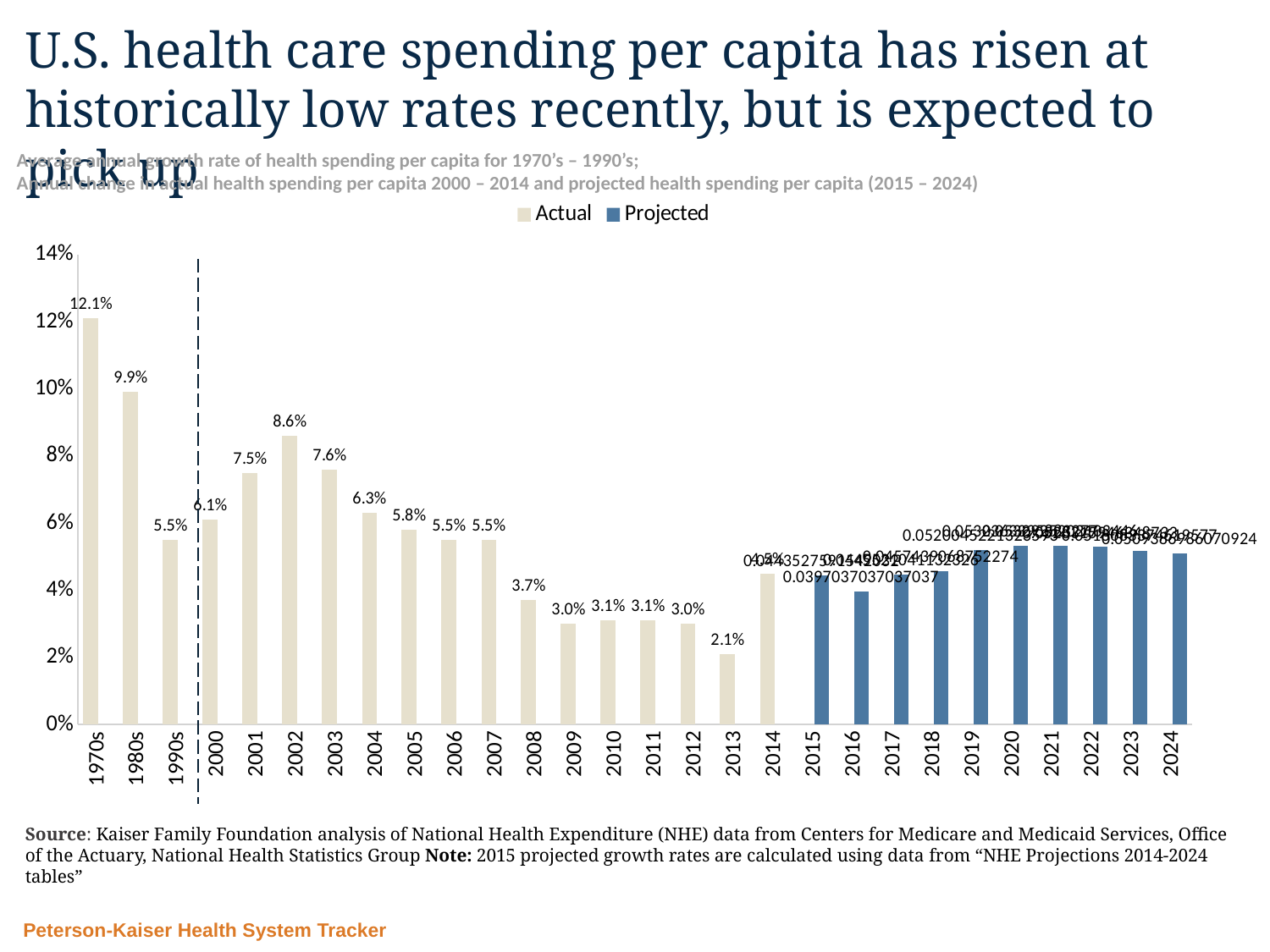
Which is larger, the value for 2001 or the value for 2003? 2003 Which category has the lowest value? 2013 What is the difference between the values for the 1970s and the 1980s? 2.2% What are the two legend entries? Actual and Projected What is the value for 2008? 3.7% What is the value for 2002? 8.6% How many series does the legend list? 2 Is the value for 2020 greater or less than 4%? greater What is the value for the 1970s? 12.1% What kind of chart is shown? bar chart What is the value for 2013? 2.1% Which category has the highest value? 1970s